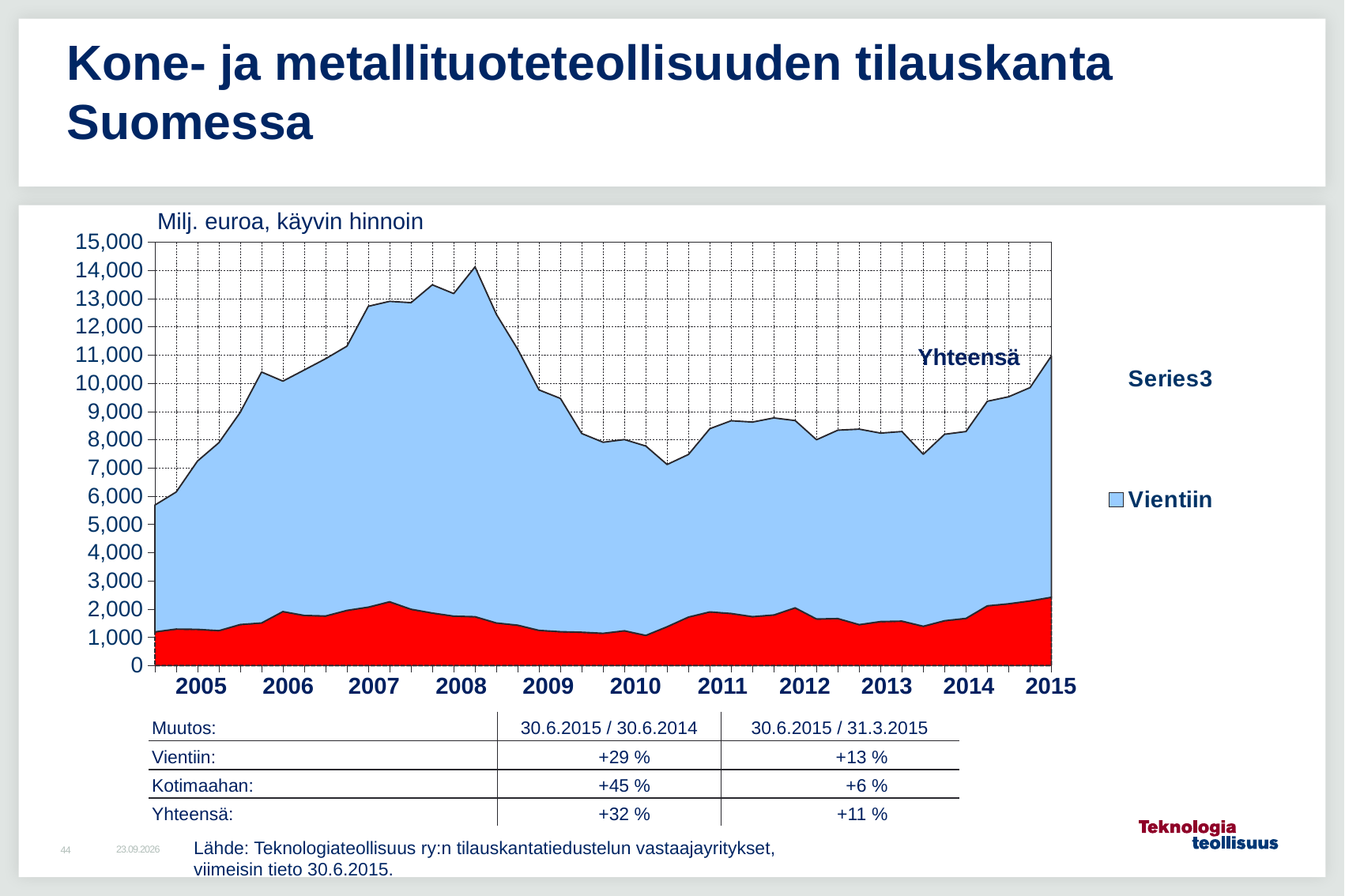
Is the total (Yhteensä) value at the start of the chart in 2005 greater or less than 7,000? less What kind of chart is shown on the slide? Area chart Is the red (bottom) area value at the end of the chart in 2015 greater or less than 2,000? greater How many series does the chart legend list? 2 Is the total (Yhteensä) higher in 2008 or in 2013? 2008 In which year does the total (Yhteensä) reach its highest point? 2008 What are the two entries in the chart legend? Series3 and Vientiin Is the total (Yhteensä) value at the end of the chart in 2015 greater or less than 10,000? greater What unit label is shown above the chart? Milj. euroa, käyvin hinnoin How many year labels are shown on the x axis? 11 Does the total (Yhteensä) rise or fall between 2008 and 2010? fall